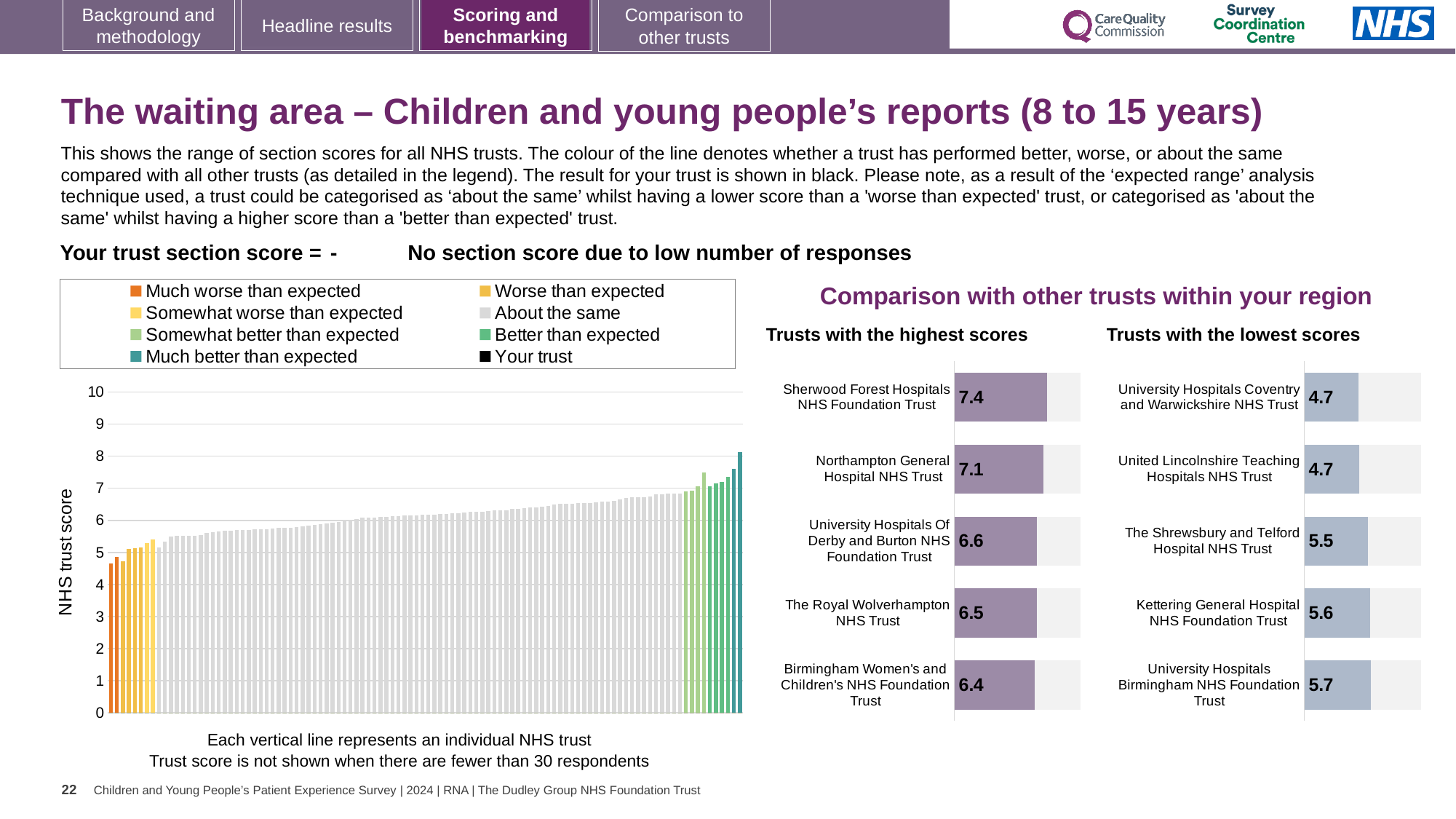
In the 'Trusts with the highest scores' chart, what is the difference between the scores of Sherwood Forest Hospitals NHS Foundation Trust and Northampton General Hospital NHS Trust? 0.3 In the 'Trusts with the lowest scores' chart, what is the difference between the scores of Kettering General Hospital NHS Foundation Trust and United Lincolnshire Teaching Hospitals NHS Trust? 0.9 In the 'Trusts with the highest scores' chart, which trust has the highest score? Sherwood Forest Hospitals NHS Foundation Trust In the 'Trusts with the lowest scores' chart, which has the larger score: The Shrewsbury and Telford Hospital NHS Trust or Kettering General Hospital NHS Foundation Trust? Kettering General Hospital NHS Foundation Trust In the 'Trusts with the highest scores' chart, what is the score for The Royal Wolverhampton NHS Trust? 6.5 How many trusts are listed in the 'Trusts with the highest scores' chart? 5 In the 'Trusts with the highest scores' chart, which trust has the lowest score? Birmingham Women's and Children's NHS Foundation Trust In the 'Trusts with the highest scores' chart, what is the score for Sherwood Forest Hospitals NHS Foundation Trust? 7.4 In the large chart on the left, do the NHS trust scores rise or fall from left to right? rise In the 'Trusts with the lowest scores' chart, which trust has the highest score? University Hospitals Birmingham NHS Foundation Trust In the 'Trusts with the lowest scores' chart, what is the score for The Shrewsbury and Telford Hospital NHS Trust? 5.5 In the 'Trusts with the lowest scores' chart, what is the score for University Hospitals Birmingham NHS Foundation Trust? 5.7